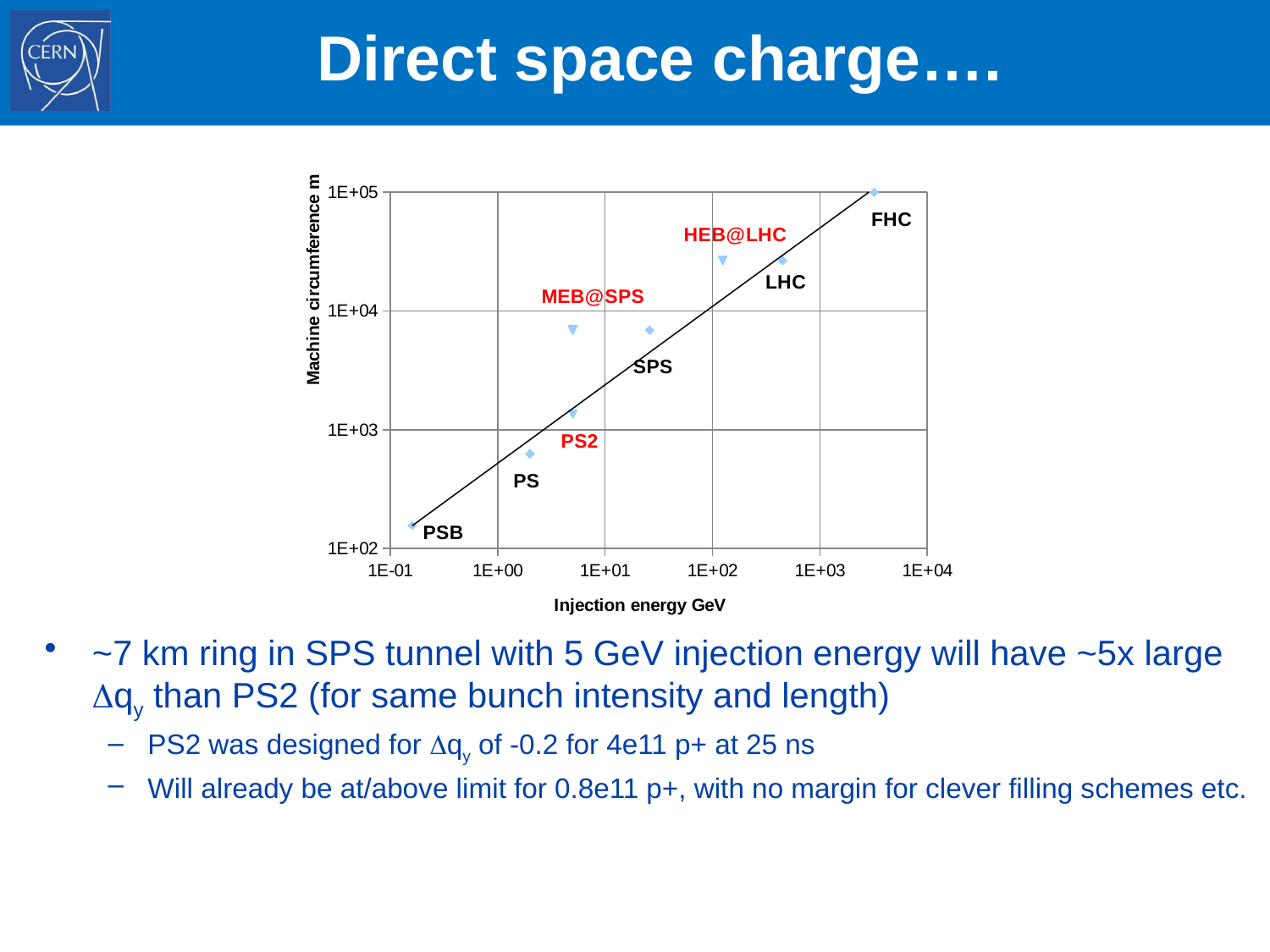
Which machine has the largest circumference on the chart? FHC Which machine has the smallest circumference on the chart? PSB Is the machine circumference for PS greater or less than 1E+03 m? less How many labelled machines are plotted on the chart? 8 Is the machine circumference for LHC greater or less than 1E+04 m? greater Which has the larger machine circumference, PS or PS2? PS2 Is the injection energy for MEB@SPS greater or less than 1E+01 GeV? less Which has the larger machine circumference, LHC or SPS? LHC What is the title of the chart's x axis? Injection energy GeV Does machine circumference rise or fall as injection energy increases along the x axis? rise What kind of chart is shown on the slide? scatter chart